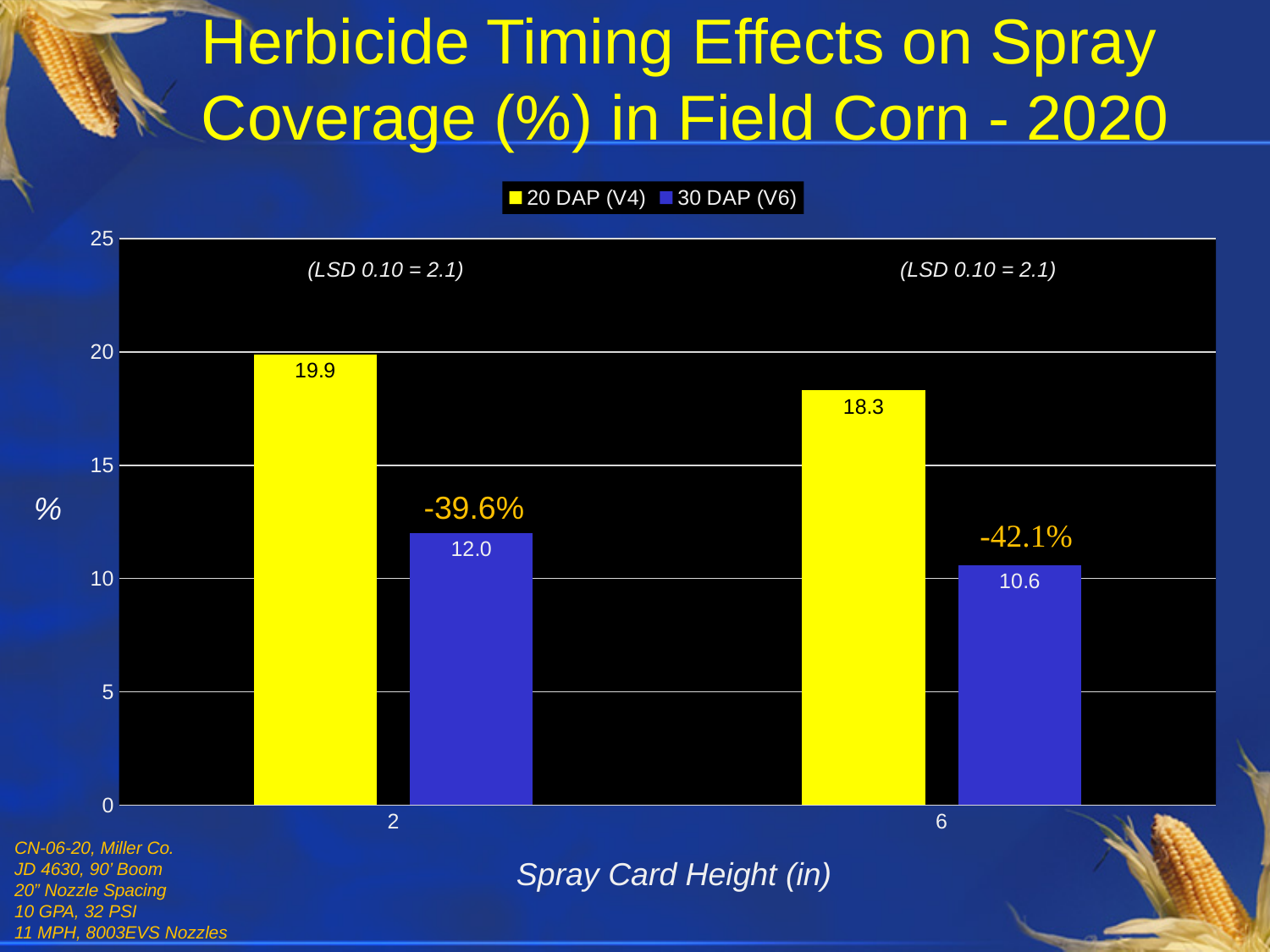
How many spray card height categories are shown on the x axis? 2 What kind of chart is shown on the slide? bar chart Is the 20 DAP (V4) value at a spray card height of 6 in greater or less than 15? greater Which is larger at a spray card height of 6 in: the 20 DAP (V4) value or the 30 DAP (V6) value? 20 DAP (V4) What is the difference between the 20 DAP (V4) and 30 DAP (V6) values at a spray card height of 2 in? 7.9 Which spray card height has the lowest 30 DAP (V6) coverage value? 6 What is the spray coverage for 20 DAP (V4) at a spray card height of 2 in? 19.9 Which spray card height has the highest 20 DAP (V4) coverage value? 2 What is the spray coverage for 30 DAP (V6) at a spray card height of 2 in? 12.0 What percentage change is annotated above the 30 DAP (V6) bar at a spray card height of 6 in? -42.1% How many series does the legend list? 2 What is the spray coverage for 30 DAP (V6) at a spray card height of 6 in? 10.6